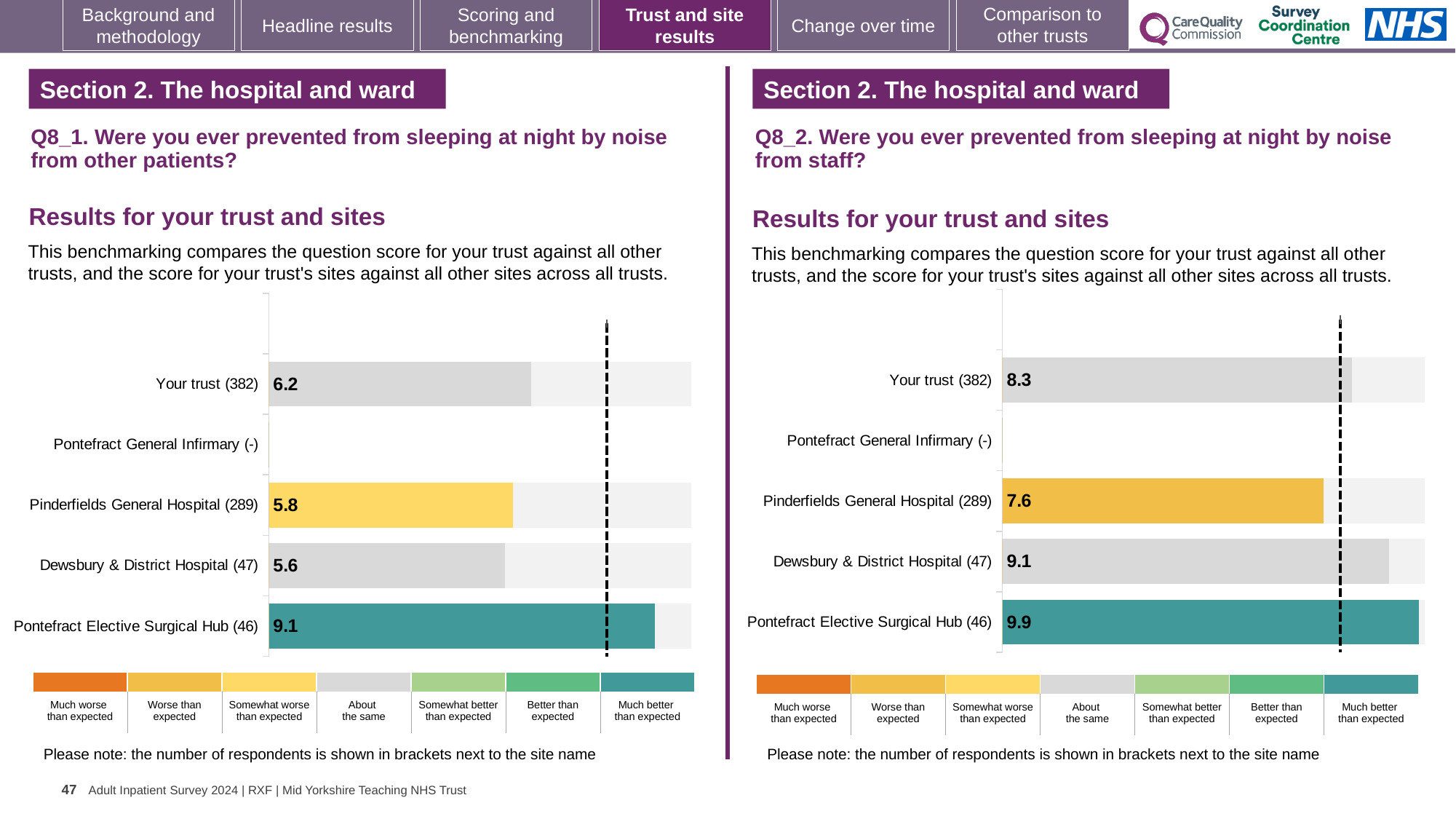
On the Q8_1 chart (left), what is the score for Your trust (382)? 6.2 On the Q8_1 chart (left), what is the score for Pinderfields General Hospital (289)? 5.8 On the Q8_2 chart (right), what is the score for Your trust (382)? 8.3 On the Q8_2 chart (right), which site has the lowest score? Pinderfields General Hospital (289) On the Q8_1 chart (left), what is the difference between the scores for Pontefract Elective Surgical Hub (46) and Dewsbury & District Hospital (47)? 3.5 On the Q8_1 chart (left), which site has the highest score? Pontefract Elective Surgical Hub (46) On the Q8_2 chart (right), what is the score for Dewsbury & District Hospital (47)? 9.1 How many site or trust labels are listed on the y axis of the Q8_1 chart (left)? 5 What kind of chart is used on the Q8_2 chart (right)? Bar chart On the Q8_1 chart (left), which site has the lowest score? Dewsbury & District Hospital (47) On the Q8_2 chart (right), what is the difference between the scores for Pontefract Elective Surgical Hub (46) and Pinderfields General Hospital (289)? 2.3 On the Q8_2 chart (right), which is larger: the score for Pontefract Elective Surgical Hub (46) or Your trust (382)? Pontefract Elective Surgical Hub (46)